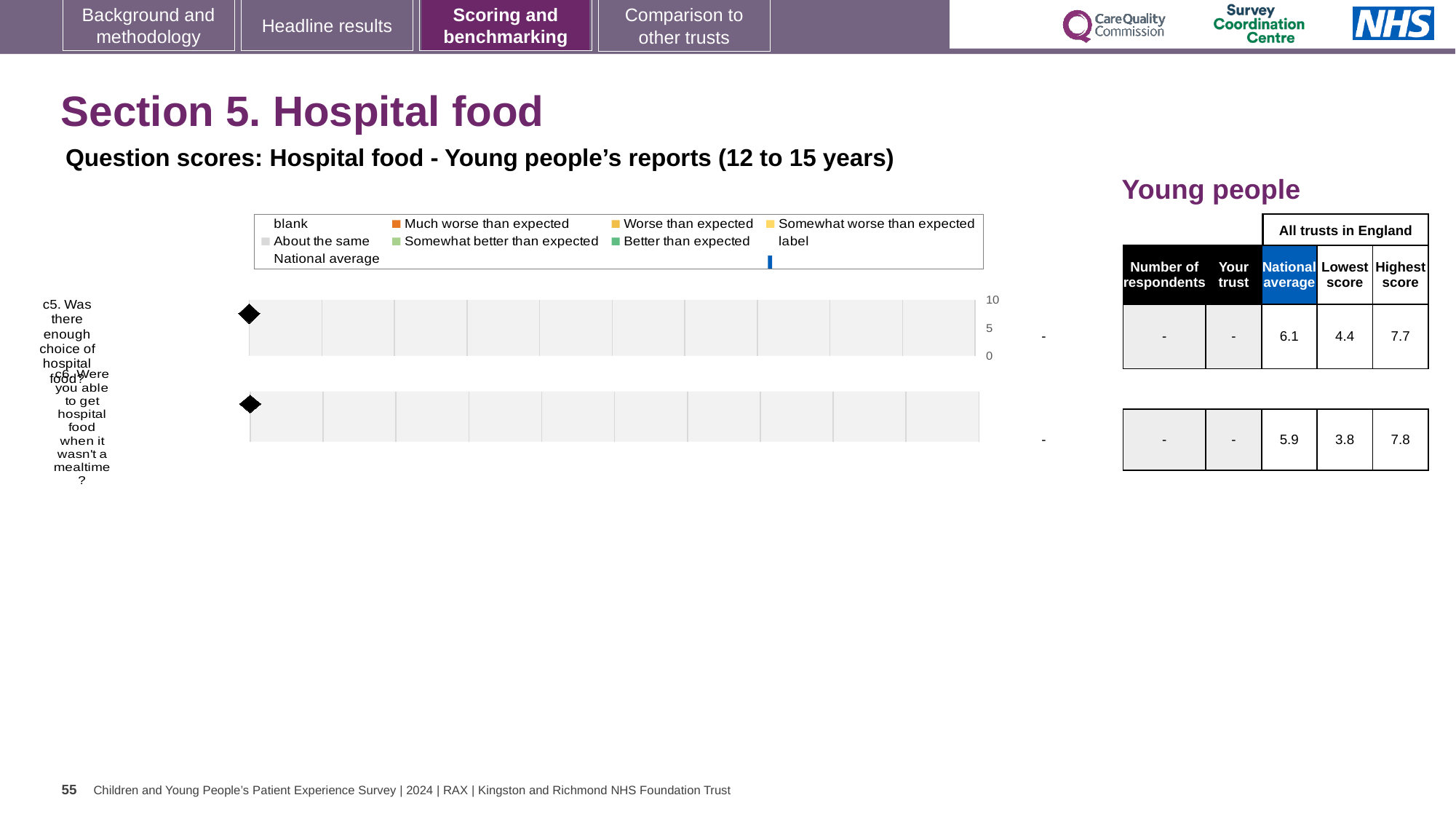
What colour is the legend marker for 'Much worse than expected'? orange What is the difference between the highest score and the lowest score for c6 in the table? 4.0 In the table, what is the lowest score across all trusts in England for c6? 3.8 In the table, what is the national average score for c6 (Were you able to get hospital food when it wasn't a mealtime?)? 5.9 In the table, what is shown as the 'Your trust' score for c5? - How many question categories are plotted on the chart? 2 What is the highest tick value shown on the chart's value axis? 10 Which question has the higher national average score, c5 or c6? c5 In the table, what is the highest score across all trusts in England for c5? 7.7 In the table, what is the national average score for c5 (Was there enough choice of hospital food?)? 6.1 What kind of chart is shown on the slide? bar chart What is the difference between the highest score and the lowest score for c5 in the table? 3.3